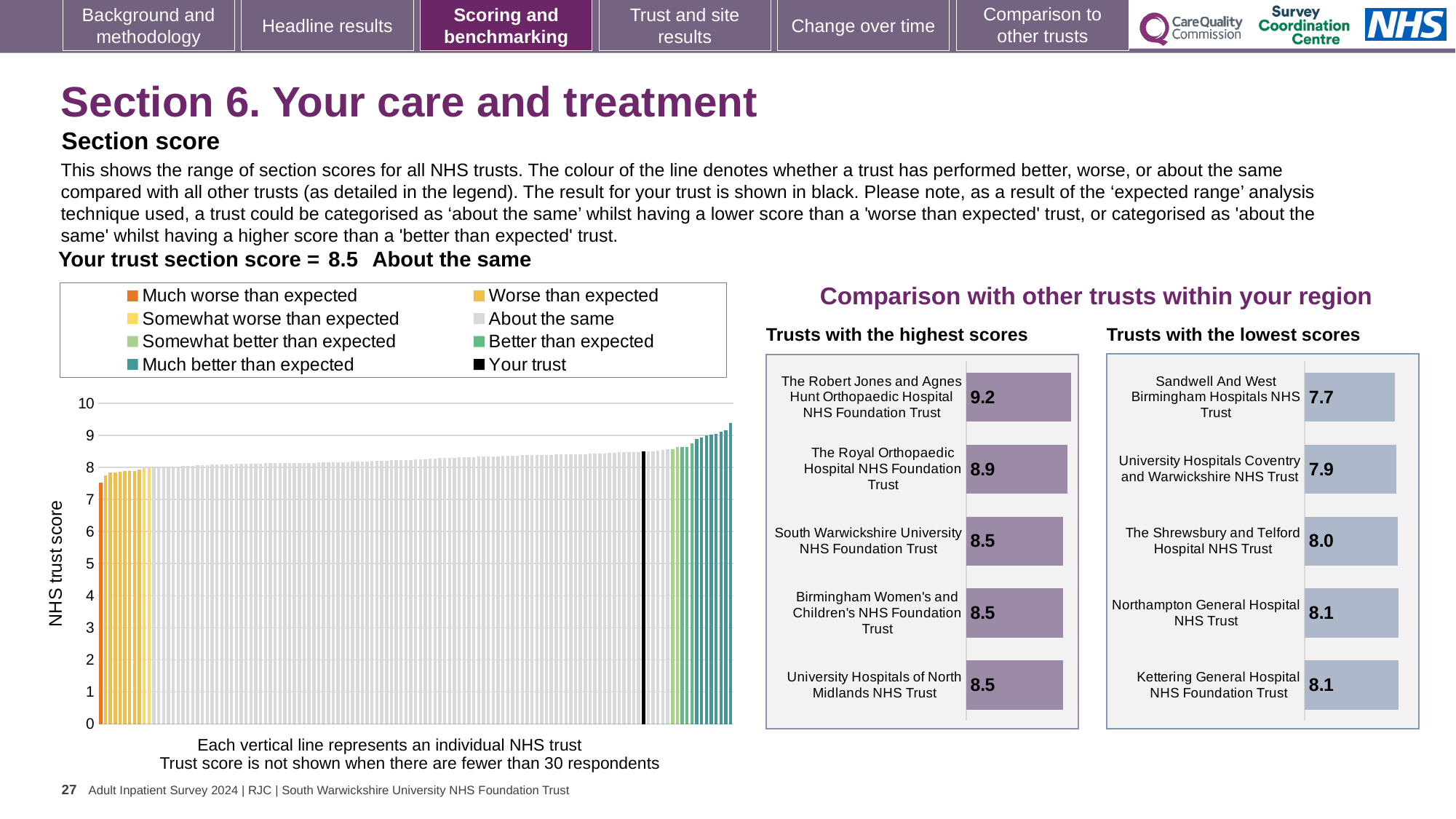
In the 'Trusts with the lowest scores' chart, which trust has the lowest score? Sandwell And West Birmingham Hospitals NHS Trust In the 'Trusts with the lowest scores' chart, what is the score for Sandwell And West Birmingham Hospitals NHS Trust? 7.7 What kind of chart is the large chart showing NHS trust scores on the left of the slide? Bar chart In the 'Trusts with the highest scores' chart, which trust has the highest score? The Robert Jones and Agnes Hunt Orthopaedic Hospital NHS Foundation Trust In the 'Trusts with the highest scores' chart, what is the difference between the scores of The Robert Jones and Agnes Hunt Orthopaedic Hospital NHS Foundation Trust and The Royal Orthopaedic Hospital NHS Foundation Trust? 0.3 In the 'Trusts with the highest scores' chart, what is the score for The Robert Jones and Agnes Hunt Orthopaedic Hospital NHS Foundation Trust? 9.2 How many entries does the legend of the large 'NHS trust score' chart list? 8 In the 'Trusts with the lowest scores' chart, which has the larger score: University Hospitals Coventry and Warwickshire NHS Trust or Northampton General Hospital NHS Trust? Northampton General Hospital NHS Trust In the 'Trusts with the highest scores' chart, what is the score for The Royal Orthopaedic Hospital NHS Foundation Trust? 8.9 In the 'Trusts with the lowest scores' chart, what is the score for The Shrewsbury and Telford Hospital NHS Trust? 8.0 How many trusts are shown in the 'Trusts with the highest scores' chart? 5 In the large 'NHS trust score' chart, is the value for the black 'Your trust' bar greater or less than 8? greater